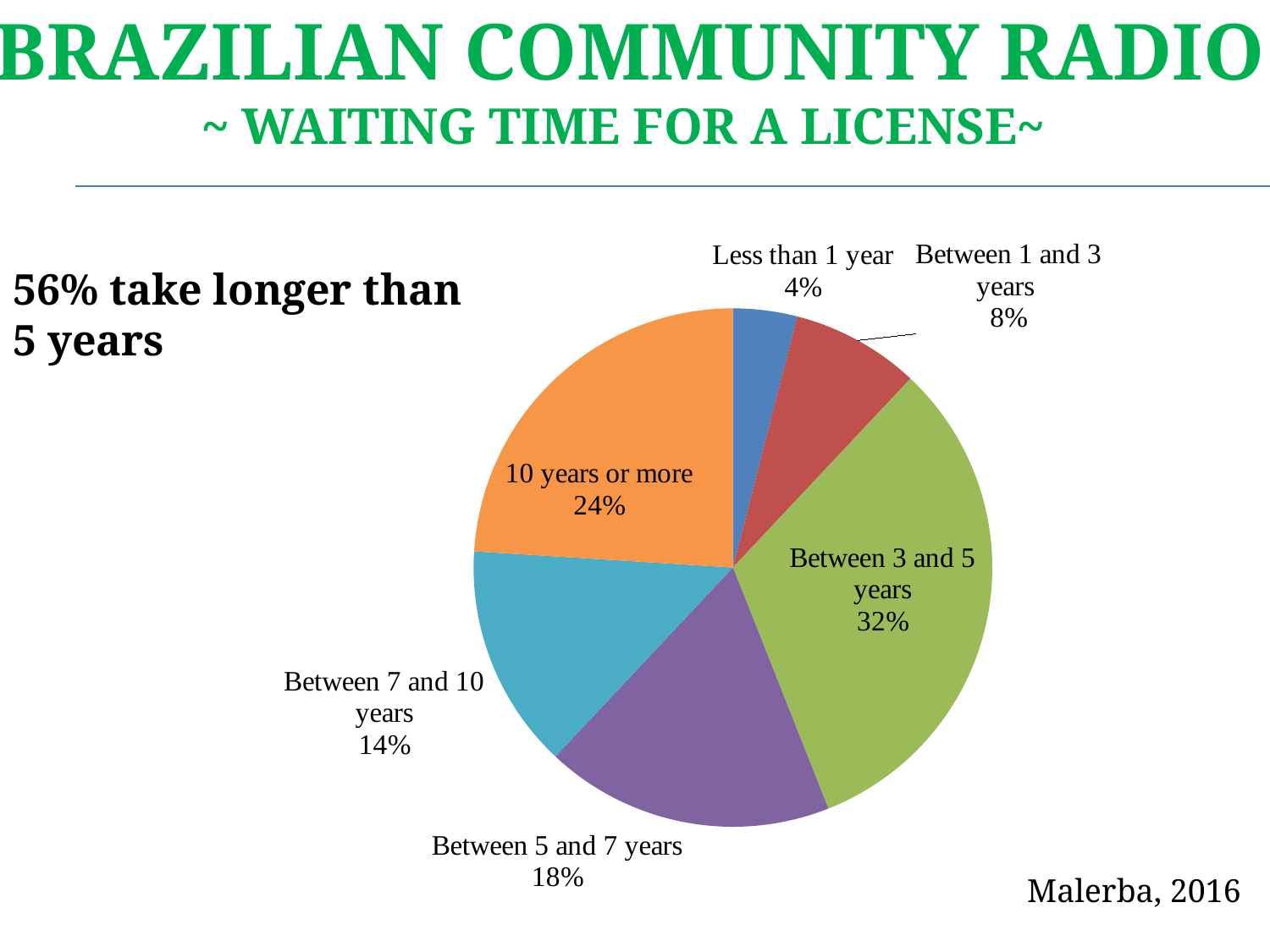
What is the combined percentage of 'Less than 1 year' and 'Between 1 and 3 years'? 12% What percentage is shown for '10 years or more'? 24% How many categories are shown in the pie chart? 6 What kind of chart is shown on the slide? pie chart What is the difference in percentage points between 'Between 3 and 5 years' and 'Between 5 and 7 years'? 14 Which category has the largest slice of the pie? Between 3 and 5 years What percentage is shown for 'Less than 1 year'? 4% What percentage is shown for 'Between 7 and 10 years'? 14% What colour is the slice for 'Between 3 and 5 years'? green Which category has the smallest slice of the pie? Less than 1 year Which is larger, the slice for '10 years or more' or the slice for 'Between 5 and 7 years'? 10 years or more What share of the pie is 'Between 3 and 5 years'? 32%